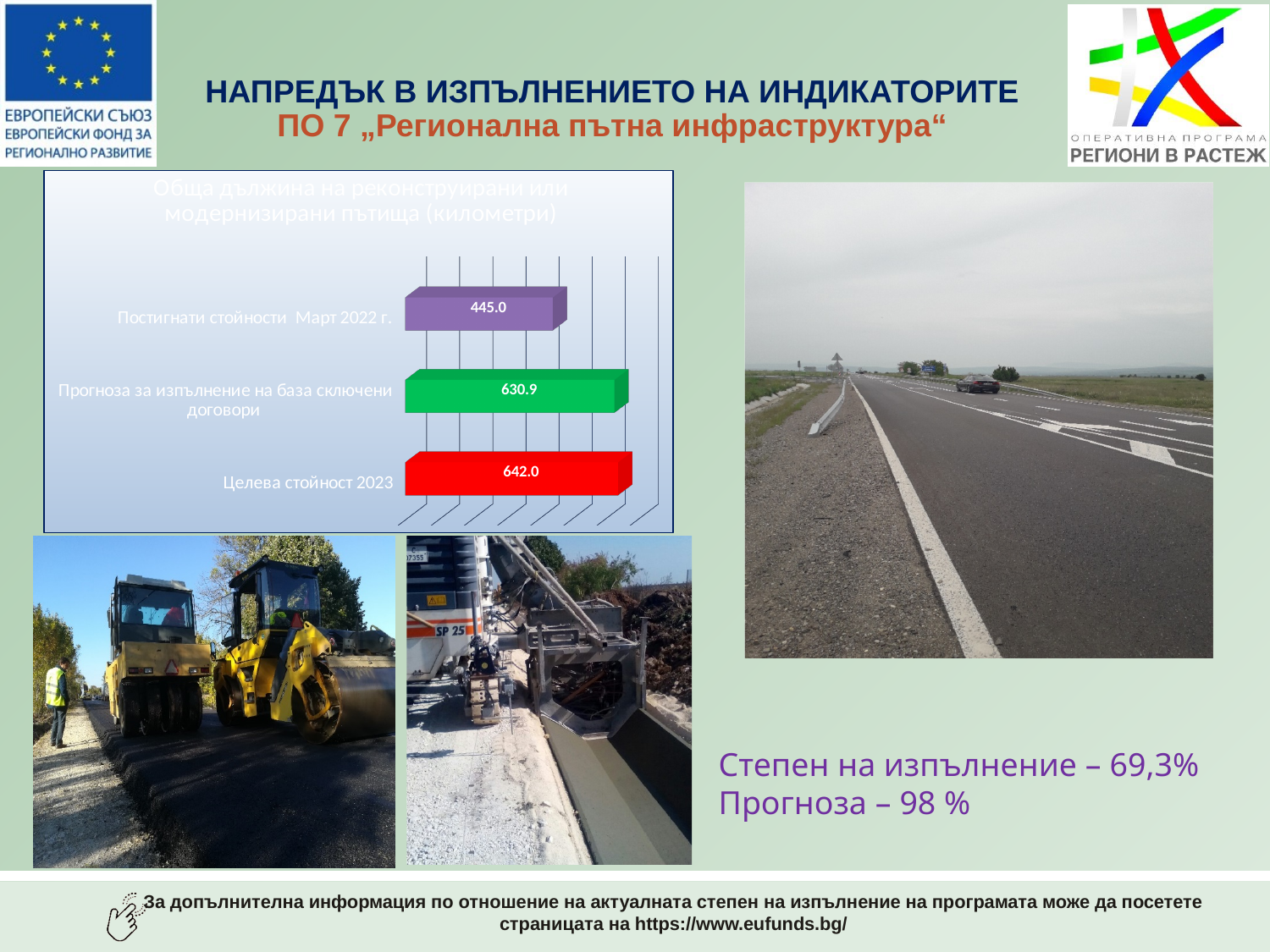
What is the value for "Целева стойност 2023"? 642.0 What colour is the bar for "Целева стойност 2023"? Red Which category has the lowest value? Постигнати стойности Март 2022 г. Which is larger: the value for "Прогноза за изпълнение на база сключени договори" or the value for "Постигнати стойности Март 2022 г."? Прогноза за изпълнение на база сключени договори What is the difference between the value for "Целева стойност 2023" and the value for "Прогноза за изпълнение на база сключени договори"? 11.1 How many categories are shown in the chart? 3 What is the title of the chart? Обща дължина на реконструирани или модернизирани пътища (километри) Which category has the highest value? Целева стойност 2023 What is the difference between the value for "Целева стойност 2023" and the value for "Постигнати стойности Март 2022 г."? 197.0 What kind of chart is shown on the slide? Bar chart What is the value for "Прогноза за изпълнение на база сключени договори"? 630.9 What is the value for "Постигнати стойности Март 2022 г."? 445.0